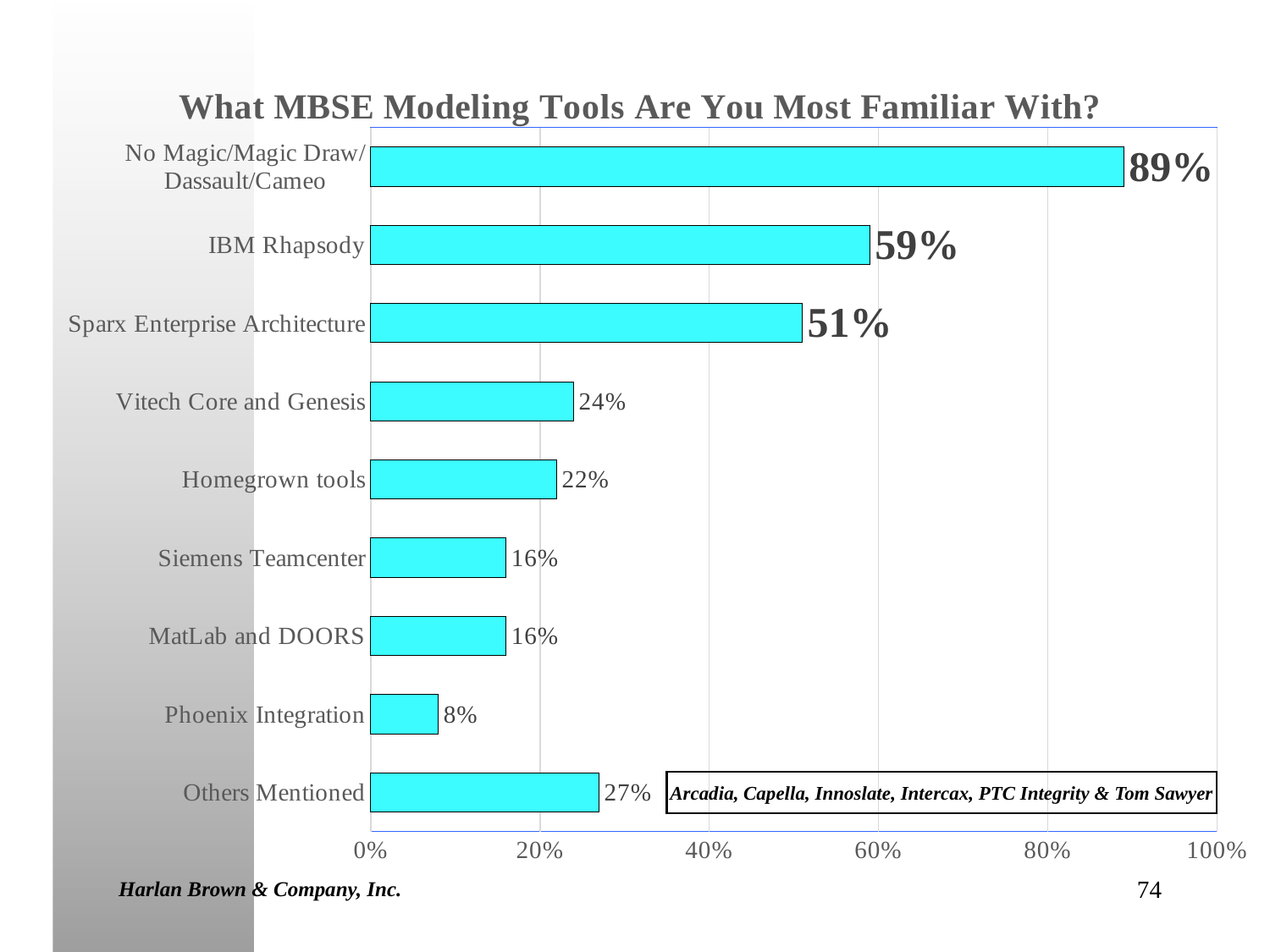
Which MBSE modeling tool has the highest percentage? No Magic/Magic Draw/Dassault/Cameo What is the title of the chart? What MBSE Modeling Tools Are You Most Familiar With? What is the value shown for Phoenix Integration? 8% Which is larger, the value for Others Mentioned or the value for Vitech Core and Genesis? Others Mentioned Is the value for Sparx Enterprise Architecture greater or less than 40%? greater What is the difference between the percentages for Sparx Enterprise Architecture and Homegrown tools? 29% What is the value shown for Vitech Core and Genesis? 24% What percentage of respondents are most familiar with IBM Rhapsody? 59% How many categories are shown in the chart? 9 What is the difference between the percentages for No Magic/Magic Draw/Dassault/Cameo and IBM Rhapsody? 30% What type of chart is shown on the slide? Bar chart Which category has the lowest percentage? Phoenix Integration